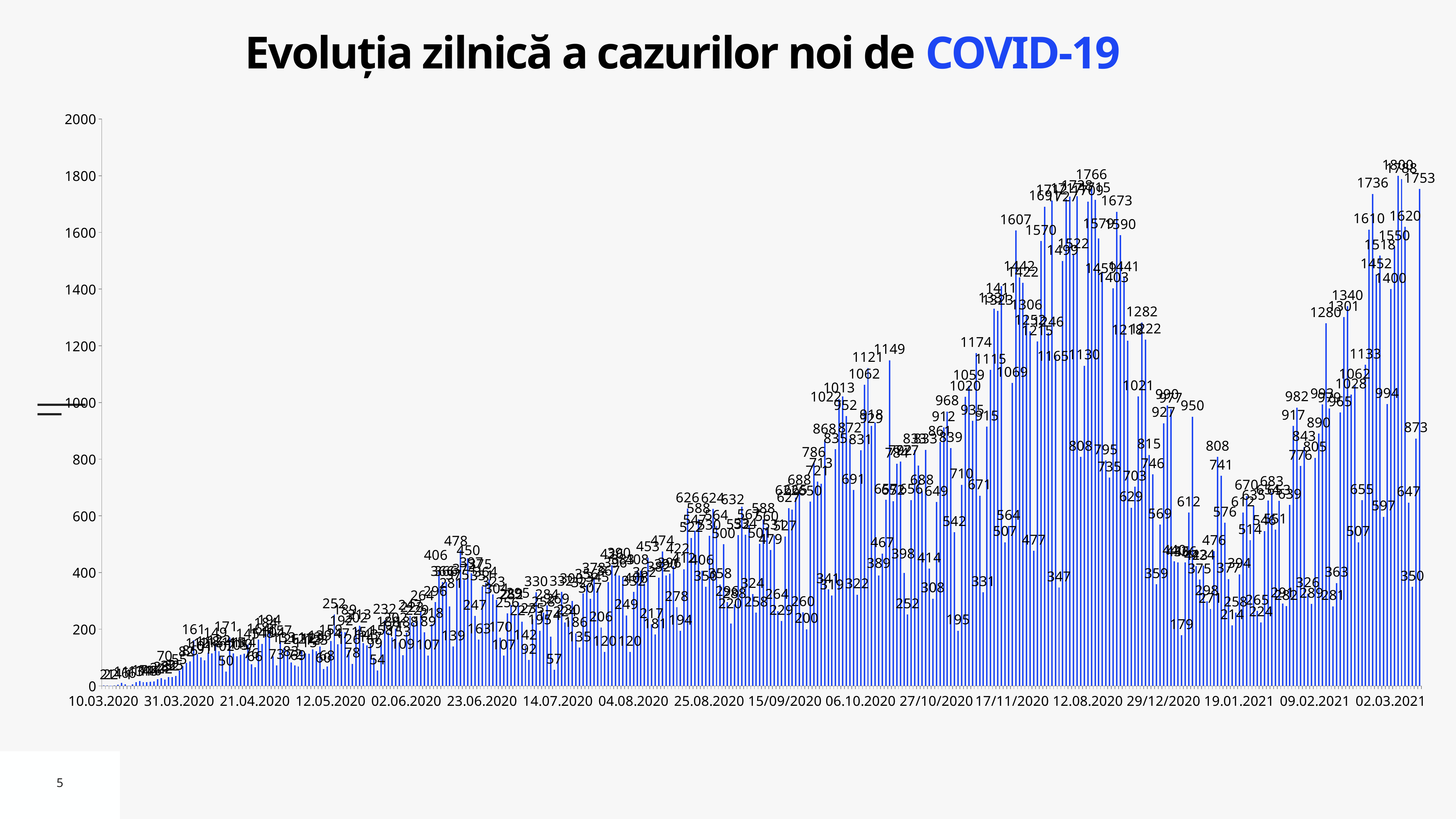
What is the highest daily value labelled on the chart? 1800 What is the value of the tallest bar in the peak around late November / early December 2020? 1766 What kind of chart is shown on the slide? bar chart Is the value of the bar labelled 873 near the right end of the chart greater or less than 1000? less Is the value of the bar labelled 1766 greater or less than 1600? greater Overall, do the daily values rise or fall from March 2020 to March 2021? rise Which is larger: the peak value of 1766 in late 2020 or the peak value of 1800 in early March 2021? 1800 What is the difference between the 1800 peak and the 1766 peak? 34 What is the maximum value shown on the vertical axis? 2000 What is the value of the rightmost (last) bar on the chart? 1753 What is the difference between the last bar (1753) and the bar labelled 873 just before it? 880 What is the title of the chart? Evoluția zilnică a cazurilor noi de COVID-19